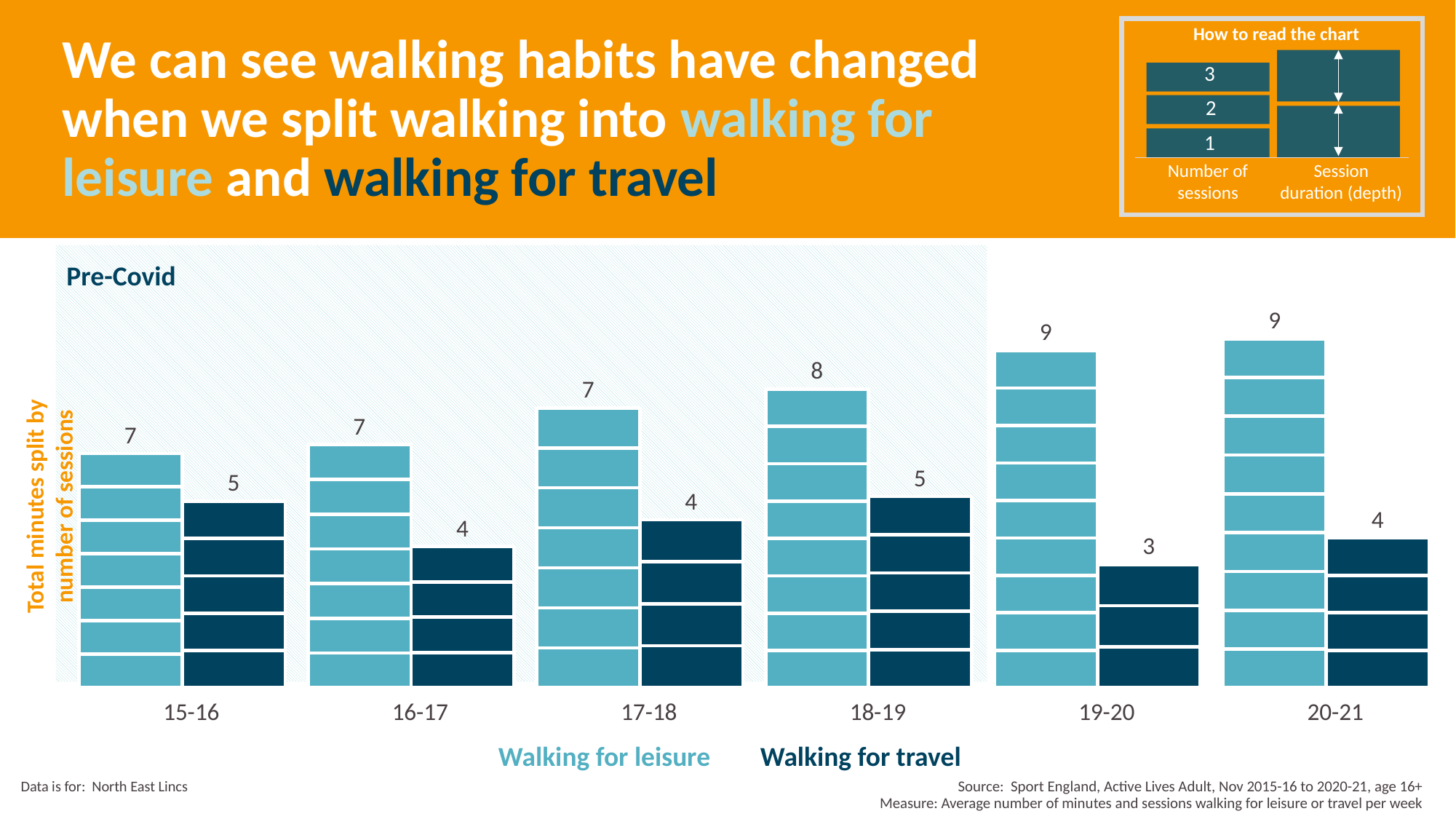
Which is larger in 16-17, walking for leisure sessions or walking for travel sessions? Walking for leisure How many years are shown on the x axis? 6 What is the number of walking for leisure sessions in 15-16? 7 What is the difference between walking for leisure and walking for travel sessions in 19-20? 6 What kind of chart is this? Bar chart What is the number of walking for travel sessions in 19-20? 3 In which year is the number of walking for travel sessions lowest? 19-20 What is the number of walking for travel sessions in 18-19? 5 Do walking for leisure sessions rise or fall from 15-16 to 20-21? Rise How many series does the legend list? 2 What is the number of walking for leisure sessions in 20-21? 9 Which years are marked as Pre-Covid on the chart? 15-16 to 18-19